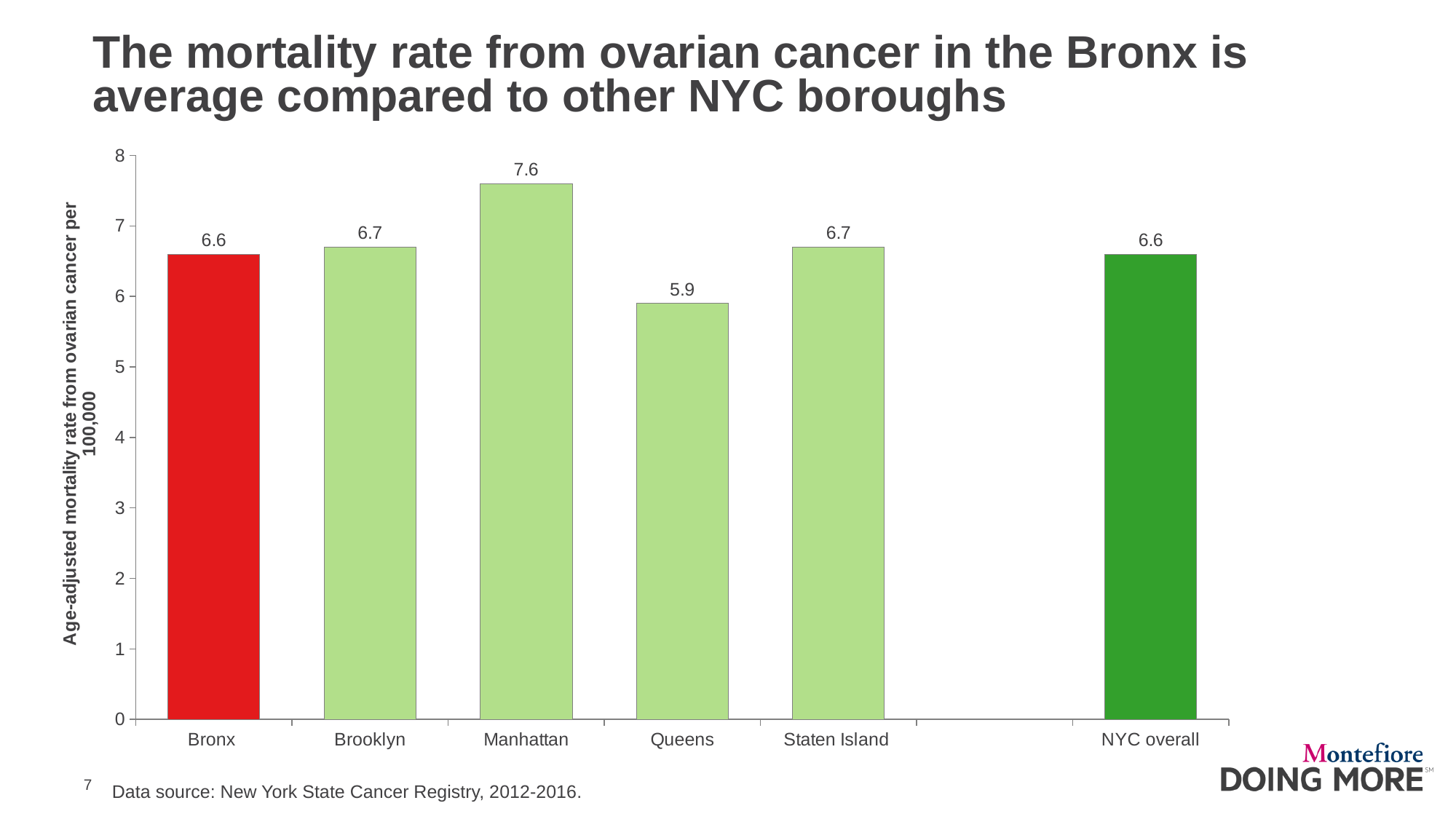
What is the age-adjusted ovarian cancer mortality rate for Manhattan? 7.6 Which has a higher ovarian cancer mortality rate, Manhattan or Brooklyn? Manhattan What is the age-adjusted ovarian cancer mortality rate for Queens? 5.9 What is the difference between the mortality rates for Manhattan and Queens? 1.7 How many bars are plotted on the chart? 6 Which borough has the lowest ovarian cancer mortality rate? Queens What kind of chart is shown on the slide? Bar chart Is the value for Queens greater or less than 6? less Which bar is coloured red? Bronx Which borough has the highest ovarian cancer mortality rate? Manhattan What is the age-adjusted ovarian cancer mortality rate for NYC overall? 6.6 What is the age-adjusted ovarian cancer mortality rate for the Bronx? 6.6